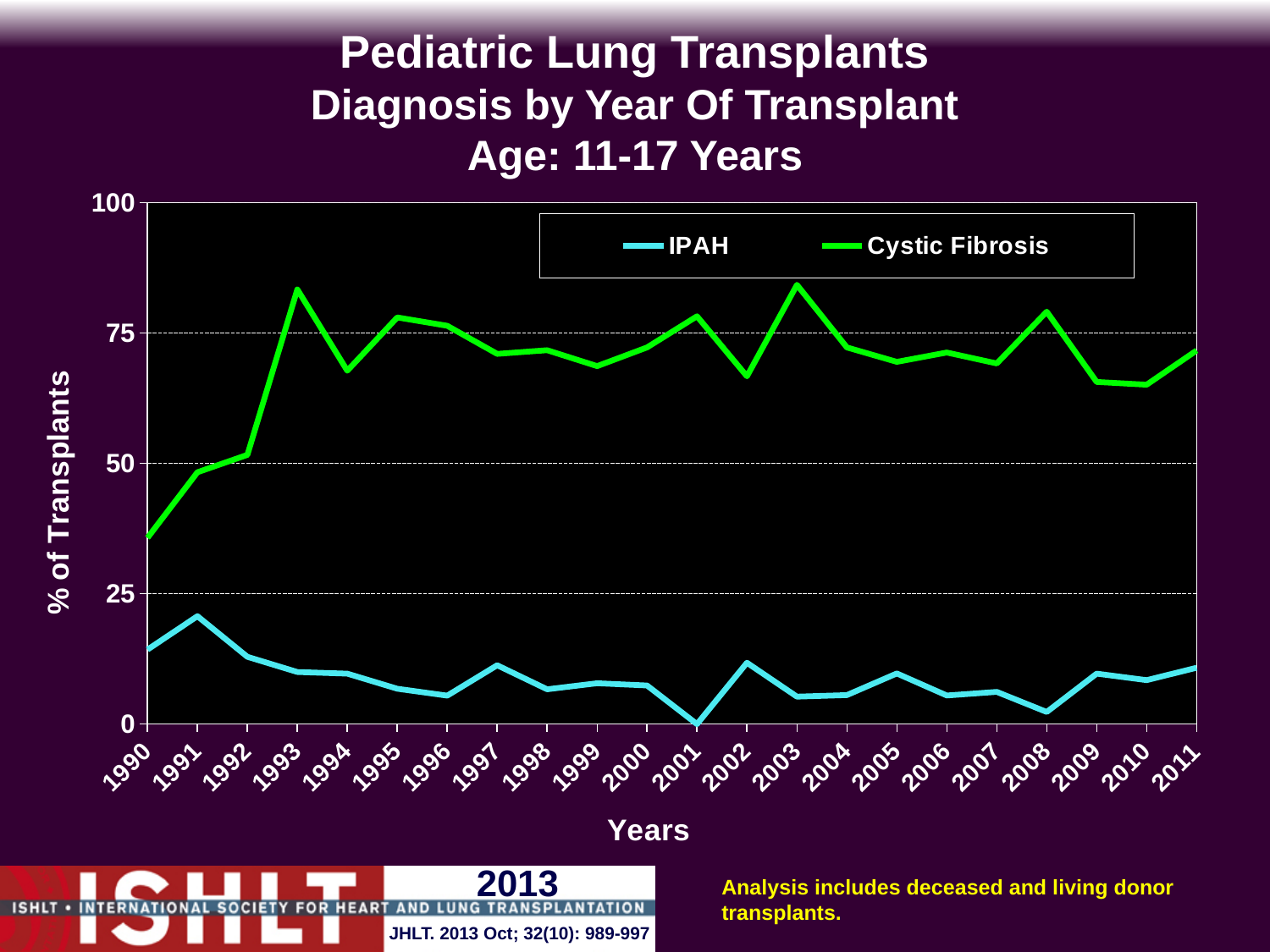
Is the Cystic Fibrosis value for 1990 greater or less than 50? less Is the Cystic Fibrosis value for 1993 greater or less than 75? greater In 2000, which series has the larger value, IPAH or Cystic Fibrosis? Cystic Fibrosis In which year is the IPAH value highest? 1991 Is the IPAH value for 1991 greater or less than 25? less In which year is the IPAH value lowest? 2001 How many years are plotted along the x axis? 22 What is the label of the y axis? % of Transplants In which year is the Cystic Fibrosis value lowest? 1990 How many series does the legend list? 2 Which series is shown in green in the legend? Cystic Fibrosis What kind of chart is shown on the slide? line chart